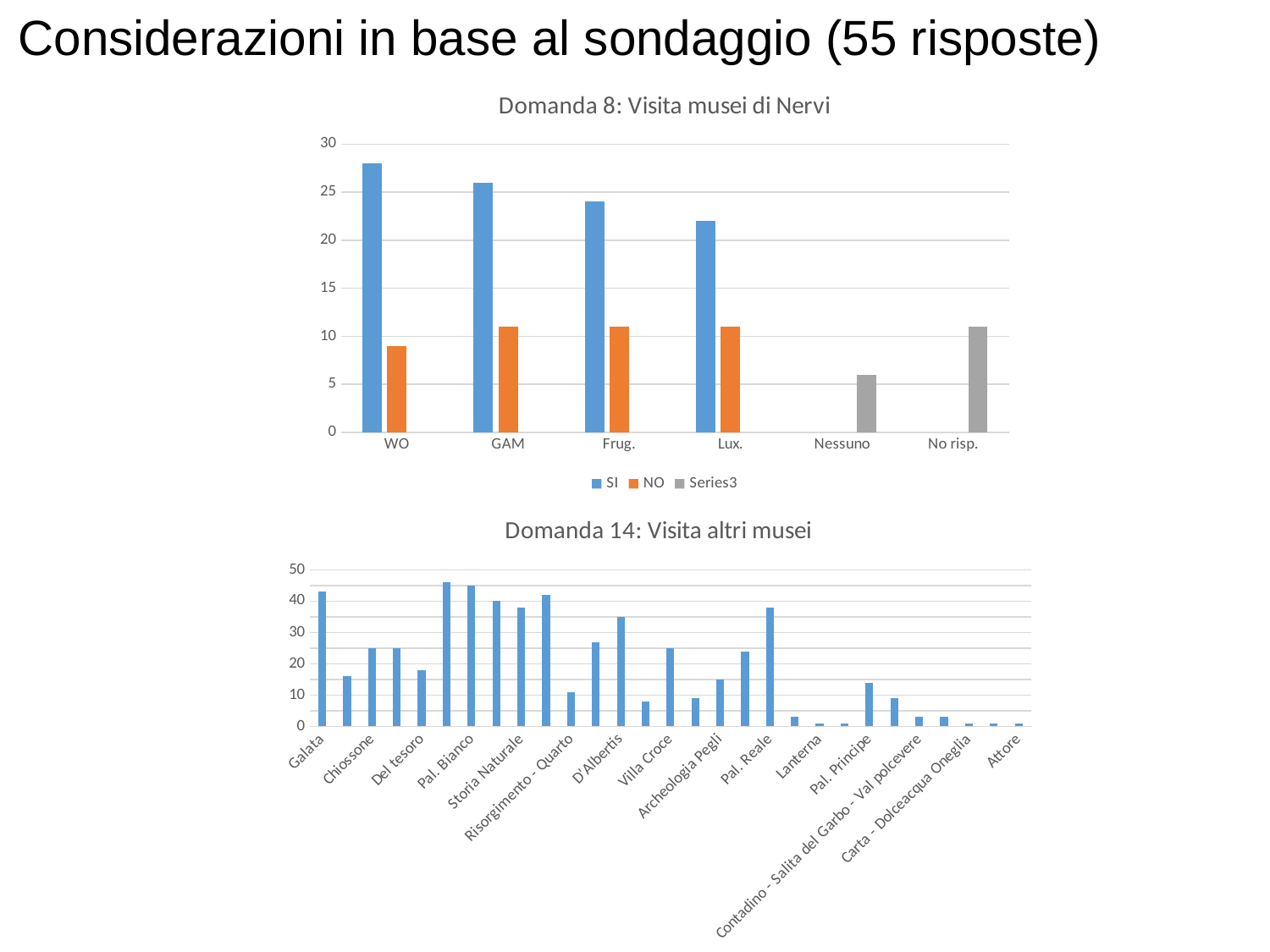
In the chart titled "Domanda 8: Visita musei di Nervi", how many series does the legend list? 3 In the chart titled "Domanda 8: Visita musei di Nervi", is the SI value for WO greater or less than 25? greater In the chart titled "Domanda 8: Visita musei di Nervi", is the SI value for Lux. greater or less than 25? less In the chart titled "Domanda 8: Visita musei di Nervi", what kind of chart is shown? bar chart In the chart titled "Domanda 8: Visita musei di Nervi", which has the larger SI value, WO or GAM? WO What is the title of the lower chart on the slide? Domanda 14: Visita altri musei In the chart titled "Domanda 8: Visita musei di Nervi", which category has the highest SI value? WO In the chart titled "Domanda 8: Visita musei di Nervi", which has the larger Series3 value, Nessuno or No risp.? No risp. In the chart titled "Domanda 8: Visita musei di Nervi", how many categories are shown on the x axis? 6 In the chart titled "Domanda 8: Visita musei di Nervi", what are the legend entries? SI, NO, Series3 In the chart titled "Domanda 14: Visita altri musei", is the value for Galata greater or less than 40? greater In the chart titled "Domanda 8: Visita musei di Nervi", do the SI values rise or fall from WO to Lux.? fall